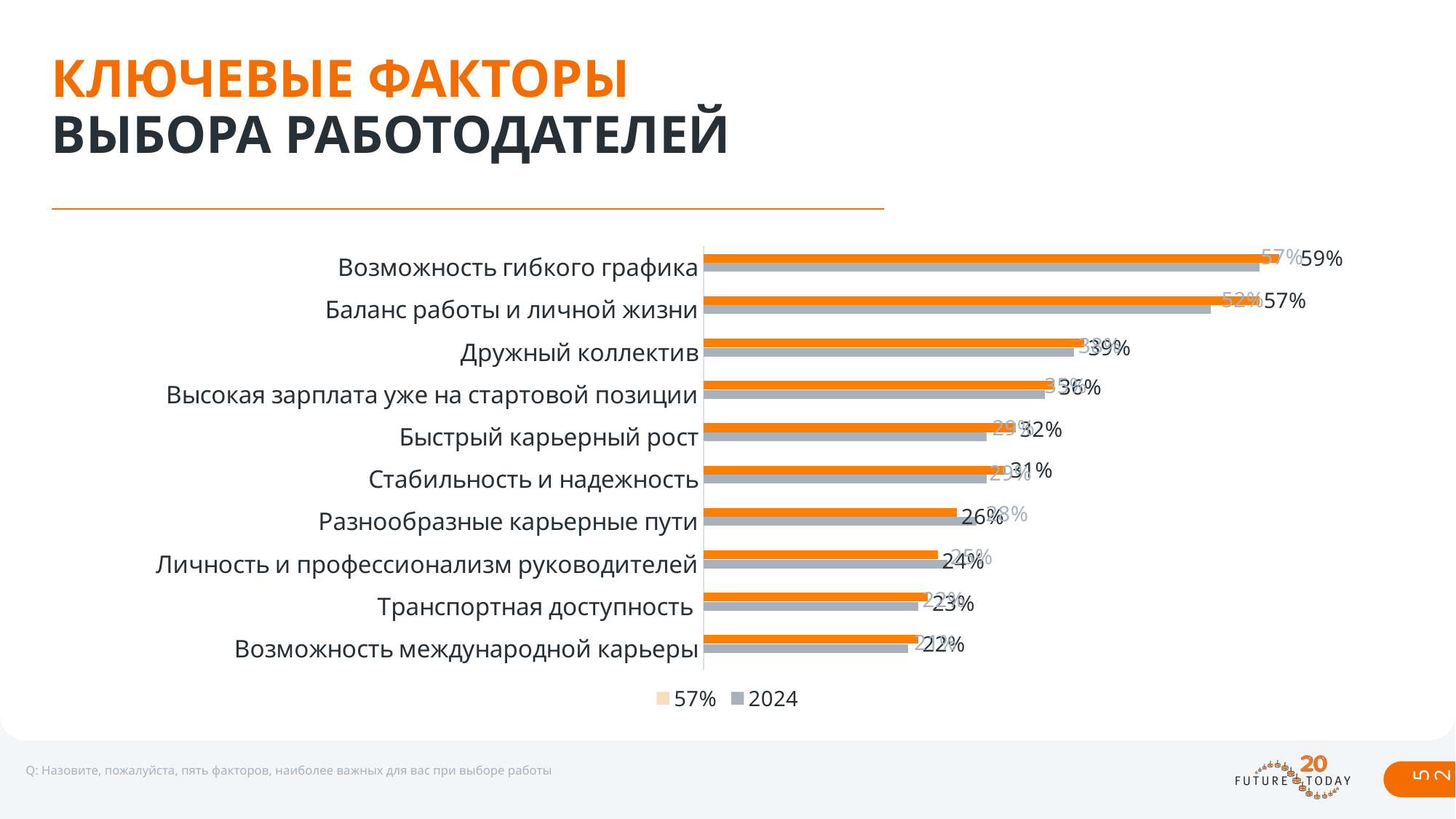
How many series does the legend list? 2 How many categories (factors) are listed on the chart? 10 What is the value of the grey (2024) bar for "Возможность гибкого графика"? 57% What is the value of the grey (2024) bar for "Баланс работы и личной жизни"? 52% Which factor has the lowest values on the chart? Возможность международной карьеры What kind of chart is shown on the slide? bar chart Which factor has the highest values on the chart? Возможность гибкого графика For "Стабильность и надежность", which bar is larger: the orange bar or the grey 2024 bar? the orange bar What is the value of the orange bar for "Возможность гибкого графика"? 59% What is the difference between the orange bar (57%) and the grey 2024 bar (52%) for "Баланс работы и личной жизни"? 5 percentage points What is the value of the orange bar for "Разнообразные карьерные пути"? 26% What is the value of the orange bar for "Быстрый карьерный рост"? 32%